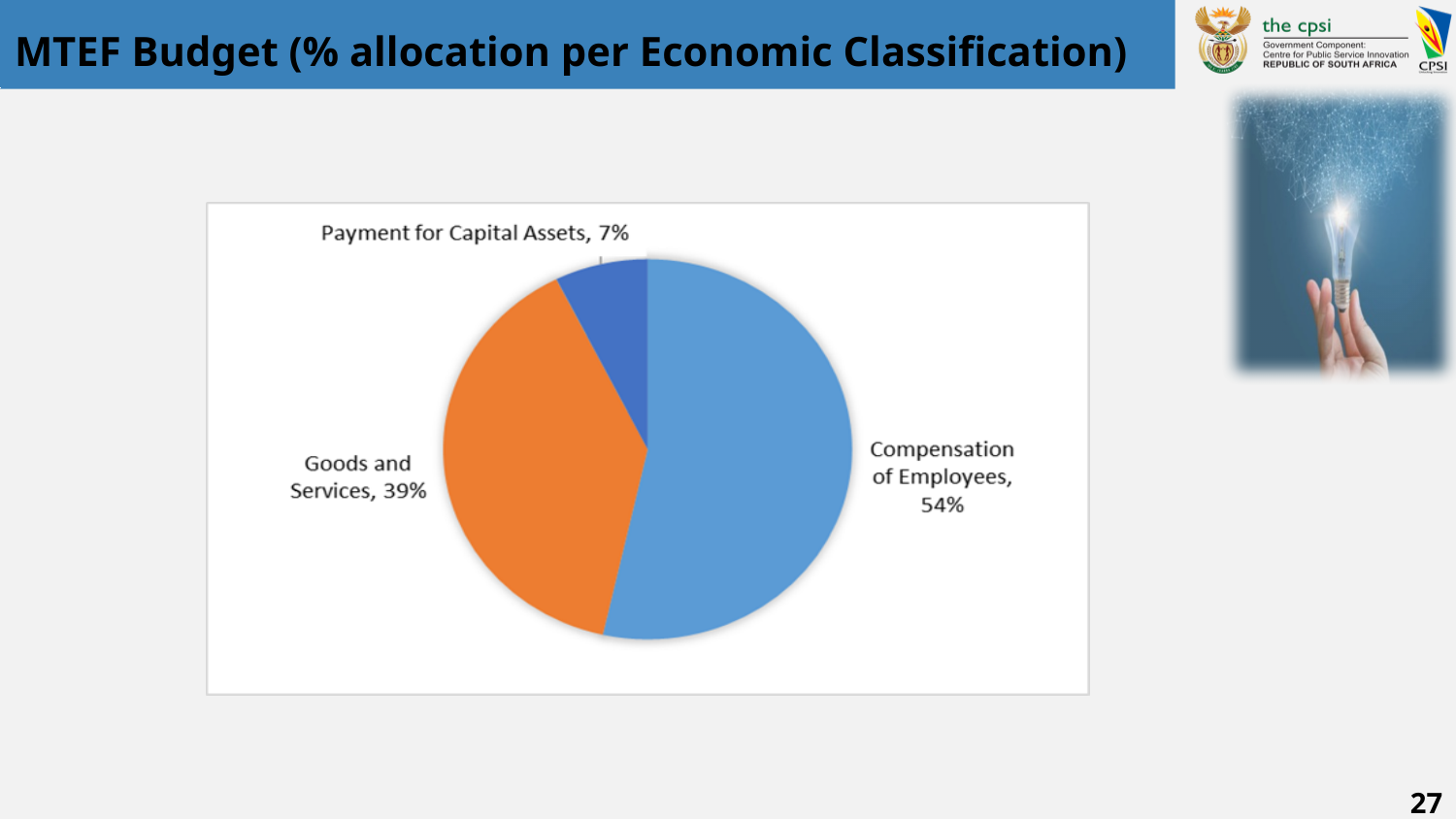
What kind of chart is shown on the slide? Pie chart What percentage of the MTEF budget is allocated to Goods and Services? 39% What is the title of the slide containing the pie chart? MTEF Budget (% allocation per Economic Classification) What colour is the Goods and Services slice? Orange How many slices does the pie chart have? 3 What percentage of the MTEF budget is allocated to Payment for Capital Assets? 7% Which economic classification has the smallest share of the MTEF budget? Payment for Capital Assets What is the difference in percentage points between Compensation of Employees and Goods and Services? 15 Which economic classification has the largest share of the MTEF budget? Compensation of Employees What percentage of the MTEF budget is allocated to Compensation of Employees? 54% What is the difference in percentage points between Goods and Services and Payment for Capital Assets? 32 Which is larger: the share for Goods and Services or the share for Payment for Capital Assets? Goods and Services